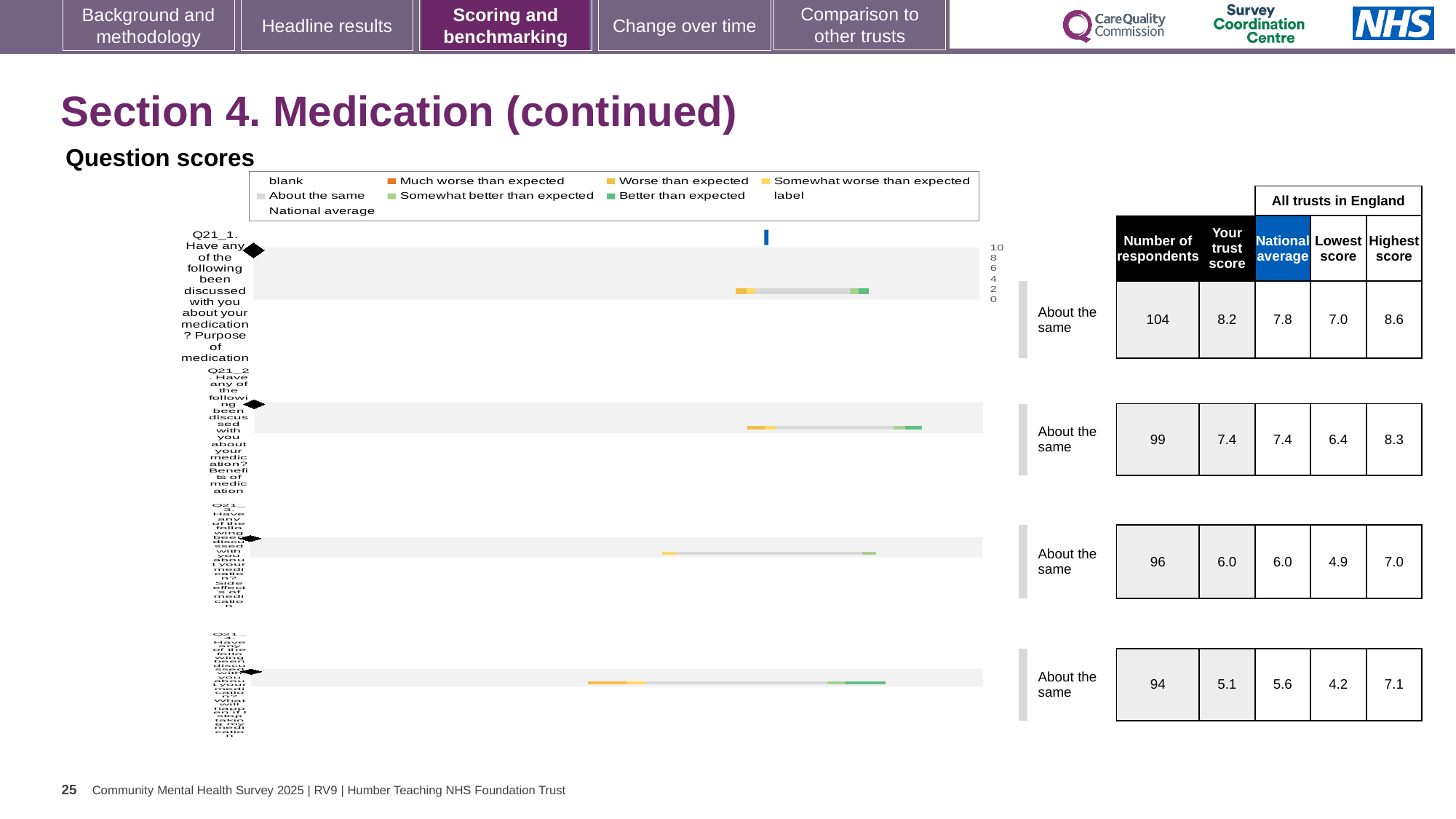
How many entries does the legend of the Question scores chart list? 9 For the first row (Q21_1), what is the difference between the highest score and the lowest score in the table? 1.6 What kind of chart is shown under 'Question scores'? bar chart Which row in the table beside the chart has the lowest 'Your trust score'? Q21_4 (5.1) In the table beside the chart, what is the number of respondents for the first row (Q21_1, Purpose of medication)? 104 For the fourth row (Q21_4), which is larger: 'Your trust score' or the national average? National average (5.6) How many question bars (rows) are plotted in the Question scores chart? 4 What benchmark label is shown to the right of each of the four bars in the Question scores chart? About the same In the table beside the chart, what is the national average for the fourth row (Q21_4)? 5.6 In the table beside the chart, what is the highest score for the second row (Q21_2)? 8.3 In the table beside the chart, what is 'Your trust score' for the first row (Q21_1)? 8.2 Which row in the table beside the chart has the highest number of respondents? Q21_1 (104)